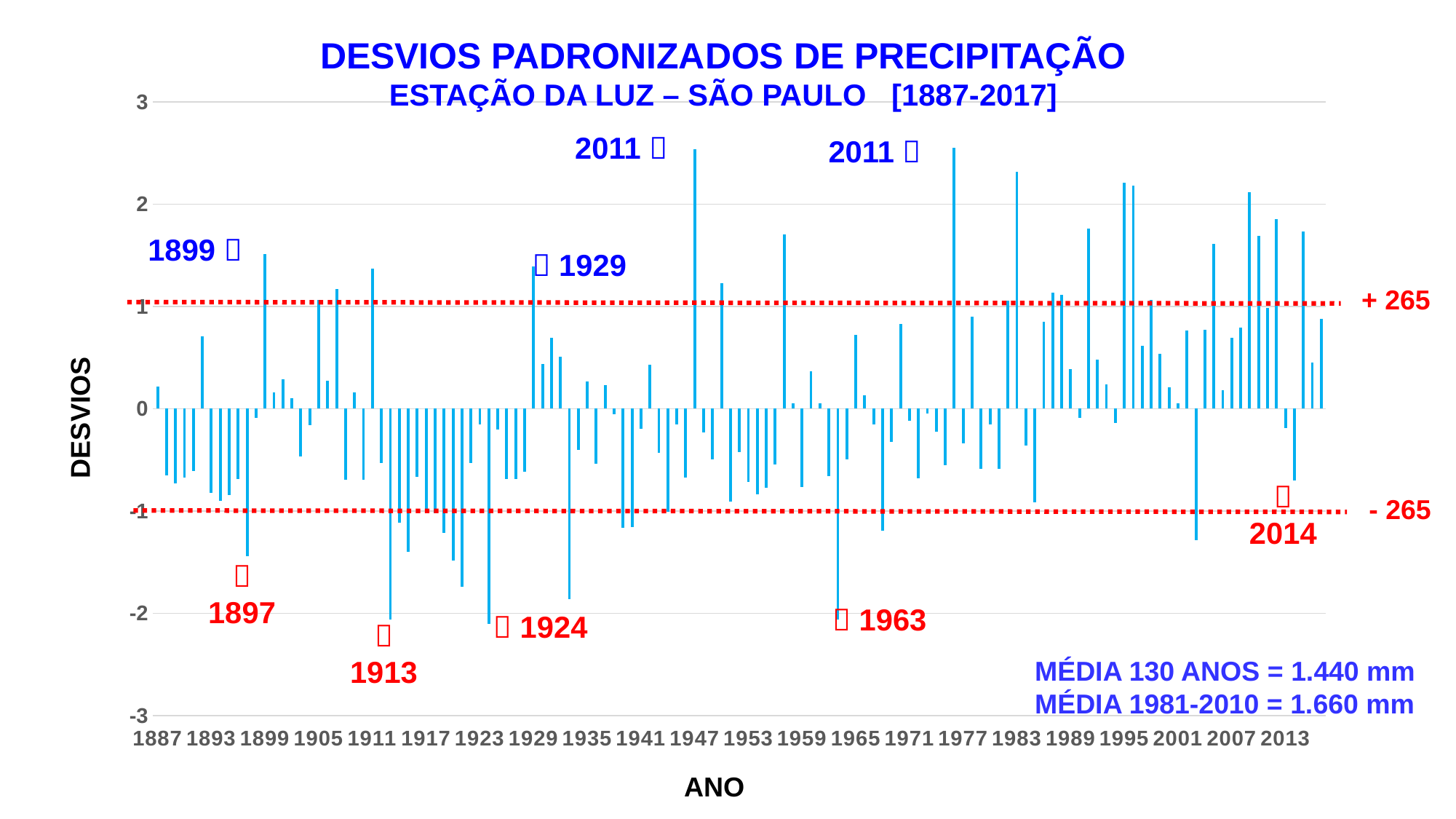
Is the deviation for 1899 greater or less than 1? greater Is the deviation for 1929 greater or less than 1? greater What is the title of the chart? DESVIOS PADRONIZADOS DE PRECIPITAÇÃO Is the deviation for 1924 greater or less than -1? less What value is labelled on the upper red dotted line? + 265 Which is larger, the deviation for 1899 or the deviation for 1897? 1899 Which is lower, the deviation for 1913 or the deviation for 2014? 1913 What kind of chart is shown on the slide? bar chart